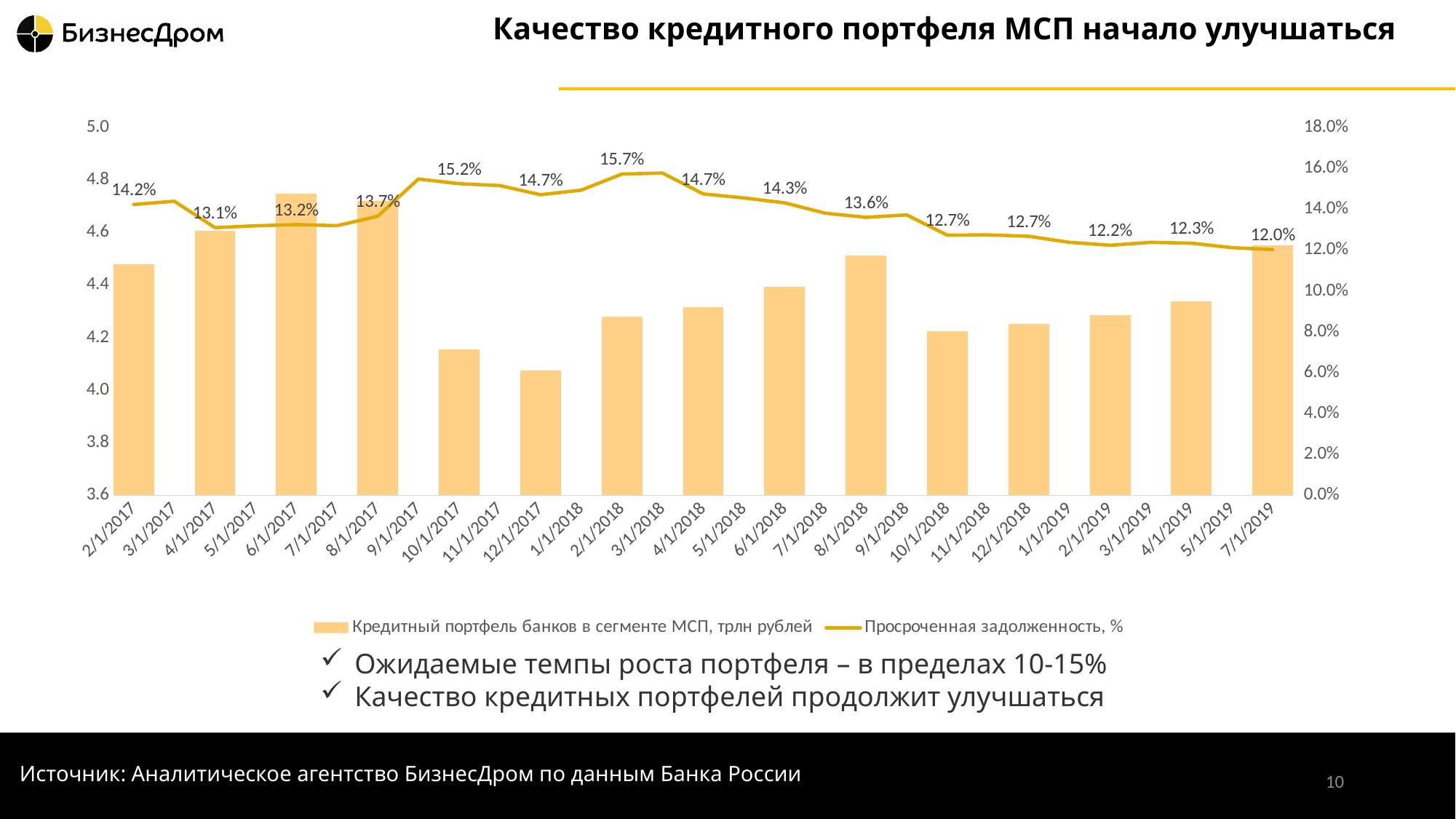
What is the difference between the overdue debt values for 2/1/2018 and 7/1/2019? 3.7 percentage points At which date does the overdue debt line reach its lowest labelled value? 7/1/2019 Is the credit portfolio bar for 6/1/2017 greater or less than 4.6 trillion rubles? greater At which date does the overdue debt line reach its highest labelled value? 2/1/2018 Does the overdue debt line rise or fall from 2/1/2018 to 7/1/2019? It falls How many bars are plotted for the credit portfolio series? 15 What is the overdue debt (Просроченная задолженность) value shown for 2/1/2018? 15.7% Which date has a higher overdue debt value: 8/1/2017 or 10/1/2017? 10/1/2017 Is the credit portfolio bar for 12/1/2017 greater or less than 4.2 trillion rubles? less What is the overdue debt value shown for 4/1/2019? 12.3% What kind of chart is shown on the slide? A combined bar and line chart How many series does the legend list? 2